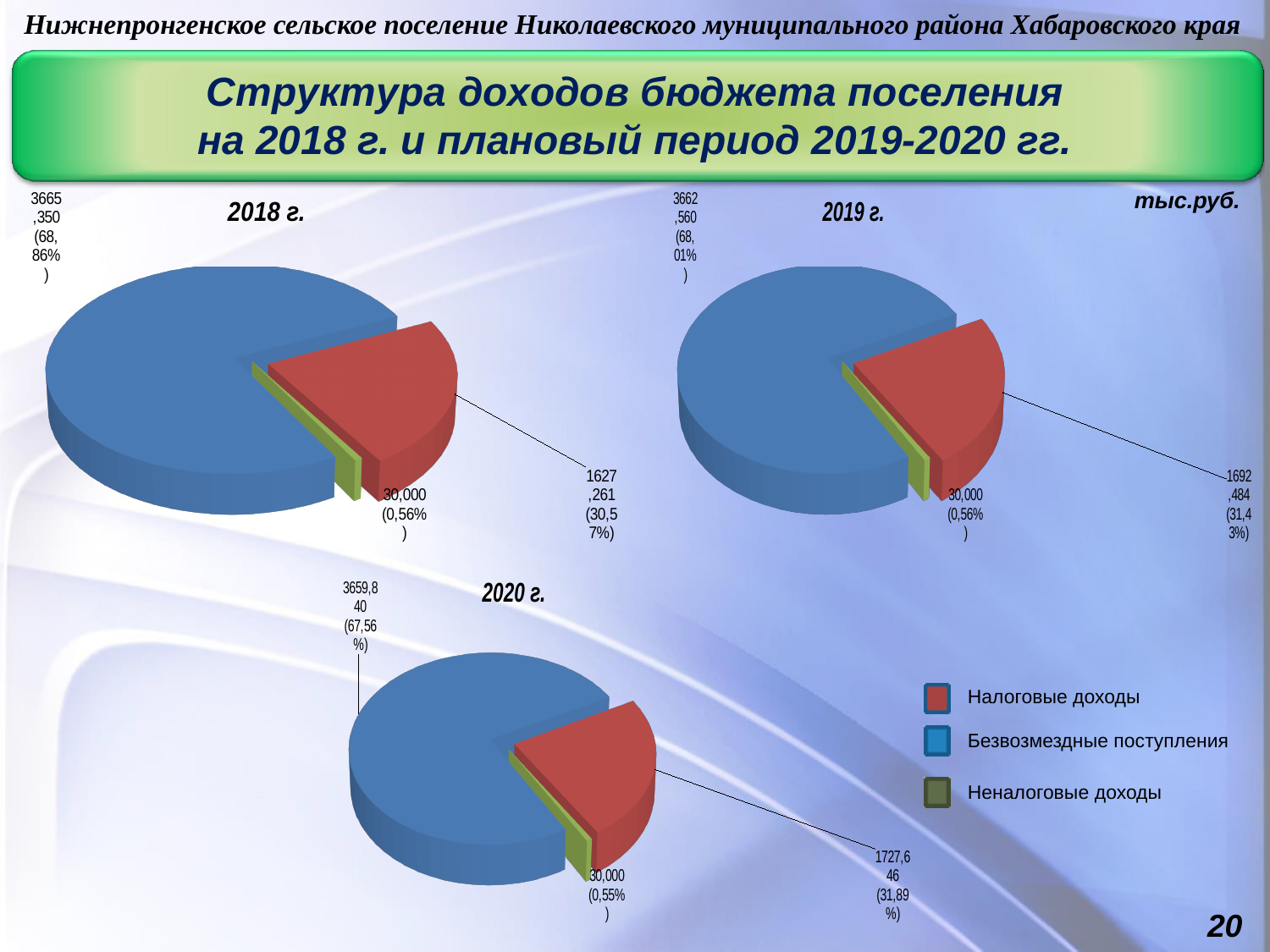
What type of chart is used for 2018 г.? Pie chart In the 2020 г. chart, which category has the largest slice? Безвозмездные поступления In the 2018 г. chart, what share of the pie is Налоговые доходы? 30,57% In the 2018 г. chart, what value is shown for Безвозмездные поступления? 3665,350 How many categories does the legend list? 3 In the 2018 г. chart, which is larger: Налоговые доходы or Безвозмездные поступления? Безвозмездные поступления In the 2019 г. chart, what share of the pie is Безвозмездные поступления? 68,01% In the 2019 г. chart, what value is shown for Налоговые доходы? 1692,484 In the 2020 г. chart, what share of the pie is Налоговые доходы? 31,89% Which colour represents Налоговые доходы in the legend? Red In the 2019 г. chart, which category has the smallest slice? Неналоговые доходы In the 2020 г. chart, what value is shown for Неналоговые доходы? 30,000